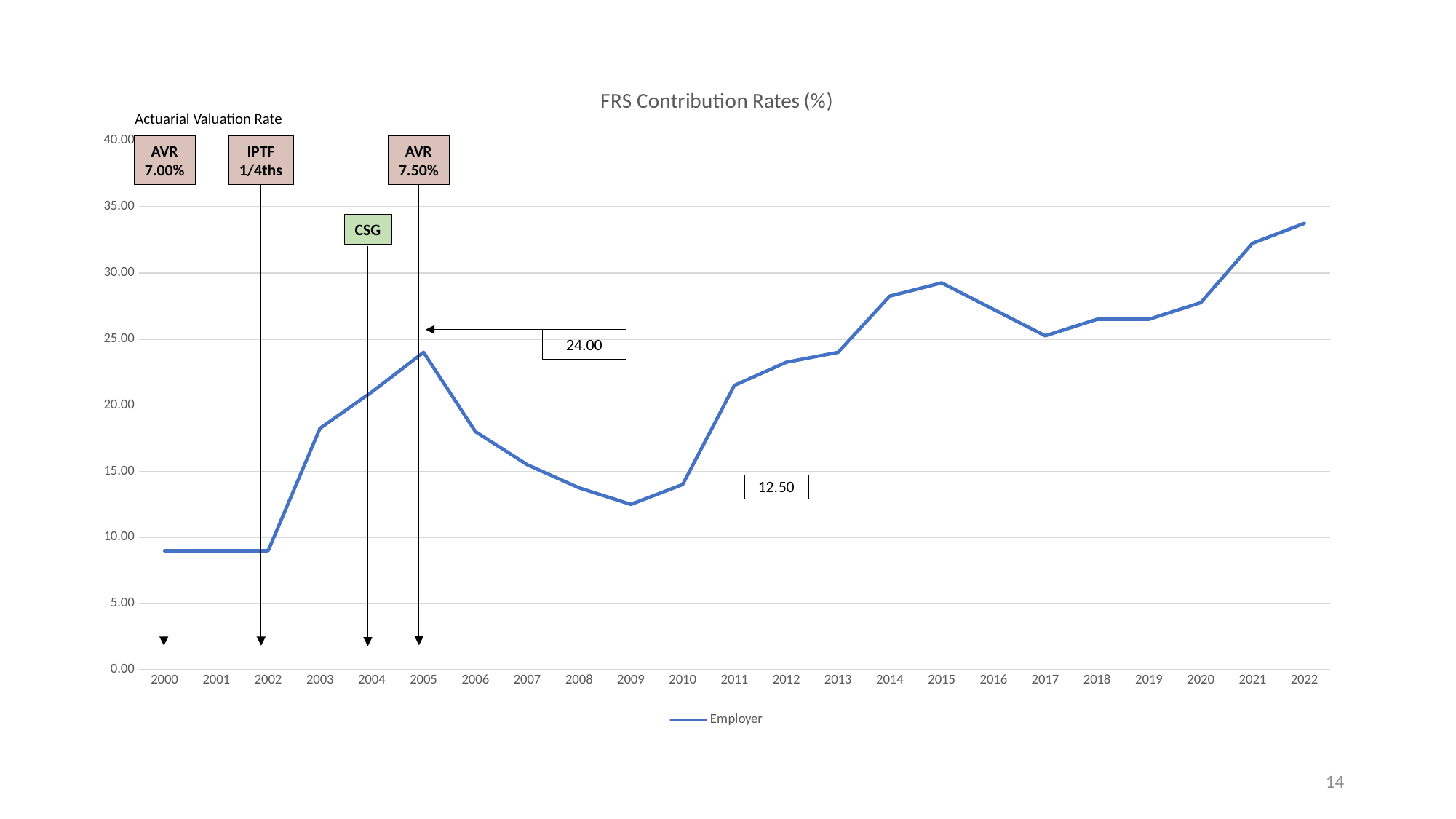
How many years are plotted along the x axis? 23 What is the Employer contribution rate labelled for 2005? 24.00 What is the difference between the labelled values for 2005 and 2009? 11.50 Which year between 2006 and 2022 has the lowest Employer contribution rate? 2009 What is the title of the chart? FRS Contribution Rates (%) Is the value for 2000 greater or less than 10.00? less What kind of chart is shown on the slide? line chart How many series does the legend list? 1 Is the value for 2015 greater or less than 25.00? greater What is the Employer contribution rate labelled for 2009? 12.50 Which year has the highest Employer contribution rate? 2022 What is the name of the series shown in the legend? Employer